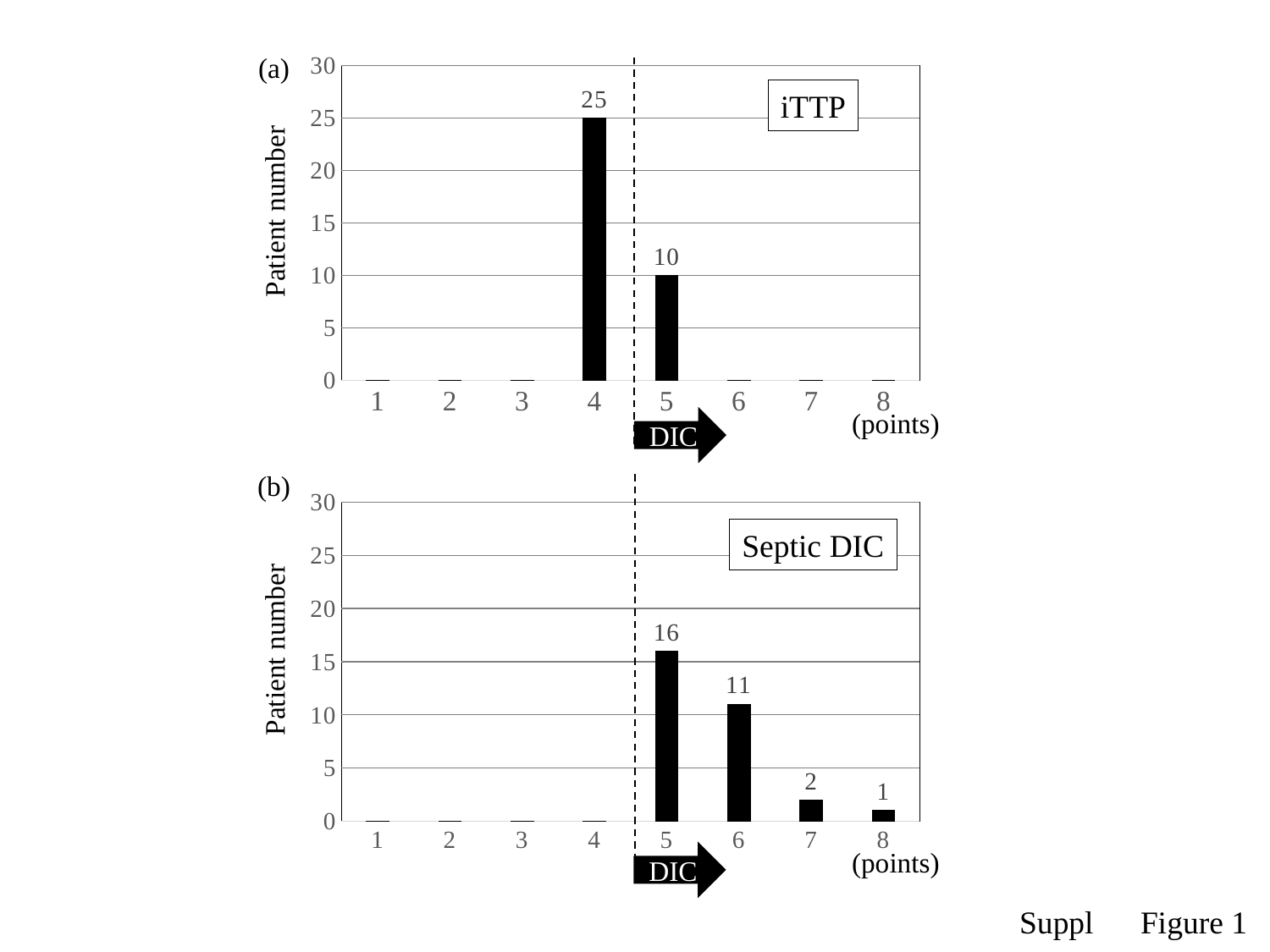
In the Septic DIC chart (b), which has a larger patient number, 7 points or 8 points? 7 points In the iTTP chart (a), what is the patient number at 4 points? 25 In the Septic DIC chart (b), what is the difference in patient number between 5 points and 6 points? 5 In the Septic DIC chart (b), what is the patient number at 6 points? 11 In the Septic DIC chart (b), which points score has the highest patient number? 5 In the iTTP chart (a), what is the difference in patient number between 4 points and 5 points? 15 In the Septic DIC chart (b), what is the patient number at 8 points? 1 In the iTTP chart (a), what is the patient number at 5 points? 10 In the Septic DIC chart (b), do the patient numbers rise or fall from 5 points to 8 points? fall What is the y-axis label of the iTTP chart (a)? Patient number What kind of chart is the Septic DIC chart (b)? bar chart How many points categories are shown on the x axis of the iTTP chart (a)? 8